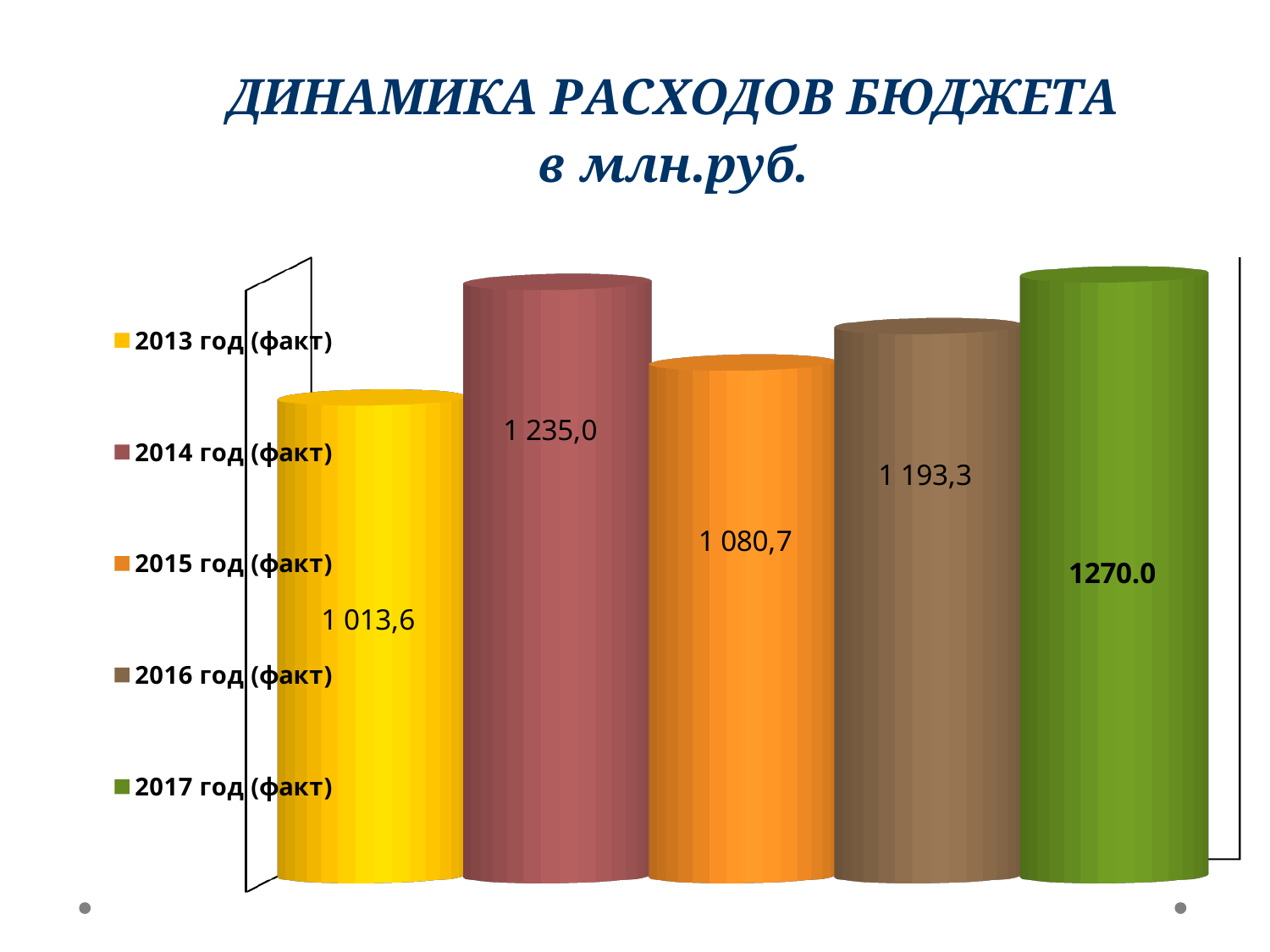
What kind of chart is shown on the slide? Bar chart Which is larger, the value for 2016 год (факт) or 2015 год (факт)? 2016 год (факт) What is the difference between the values for 2014 год (факт) and 2013 год (факт)? 221,4 How many bars are plotted on the chart? 5 What is the value for 2016 год (факт)? 1 193,3 What is the value for 2013 год (факт)? 1 013,6 What is the value for 2015 год (факт)? 1 080,7 How many entries does the legend list? 5 Which year has the highest budget expenditure? 2017 год (факт) What is the value for 2014 год (факт)? 1 235,0 Which year has the lowest budget expenditure? 2013 год (факт) What is the value for 2017 год (факт)? 1270.0